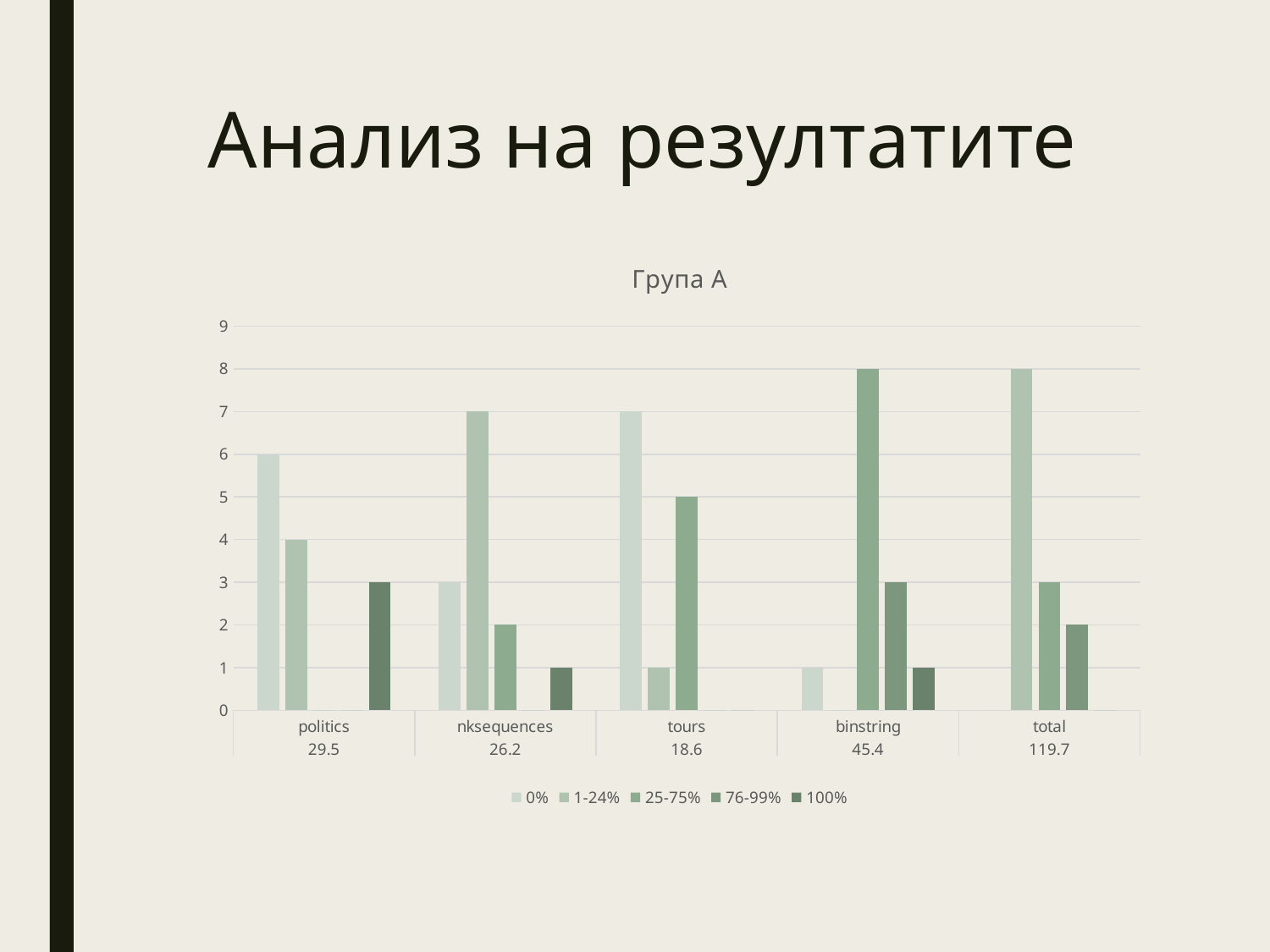
What is the title of the chart? Група А What kind of chart is shown on the slide? bar chart How many categories are shown on the x axis? 5 For nksequences, which is larger: the 0% series or the 1-24% series? 1-24% What is the value of the 0% series for politics? 6 Which category has the highest value for the 0% series? tours Which category has the lowest value for the 0% series? total How many series does the legend list? 5 What is the value of the 100% series for politics? 3 What is the value of the 25-75% series for binstring? 8 What is the difference between the 0% and 25-75% values for tours? 2 What is the value of the 1-24% series for nksequences? 7